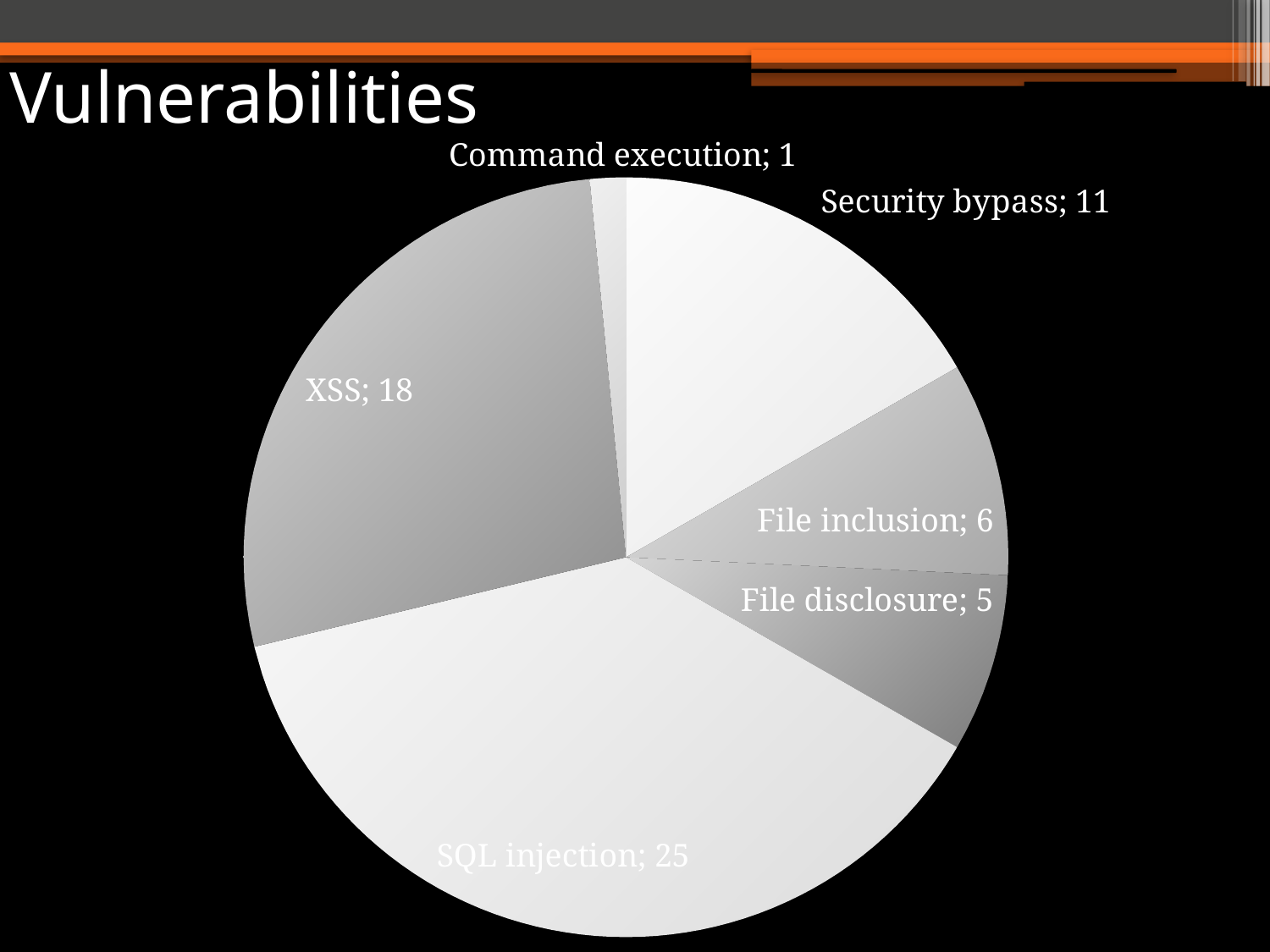
What is the title of the slide containing the chart? Vulnerabilities Which vulnerability category has the smallest slice? Command execution What is the value for SQL injection? 25 How many categories are shown in the pie chart? 6 What is the value for File inclusion? 6 What is the value for XSS? 18 What is the difference between the values for SQL injection and XSS? 7 What is the value for Command execution? 1 Which vulnerability category has the largest slice? SQL injection What is the value for Security bypass? 11 What type of chart is shown on the slide? Pie chart Which is larger, File inclusion or File disclosure? File inclusion